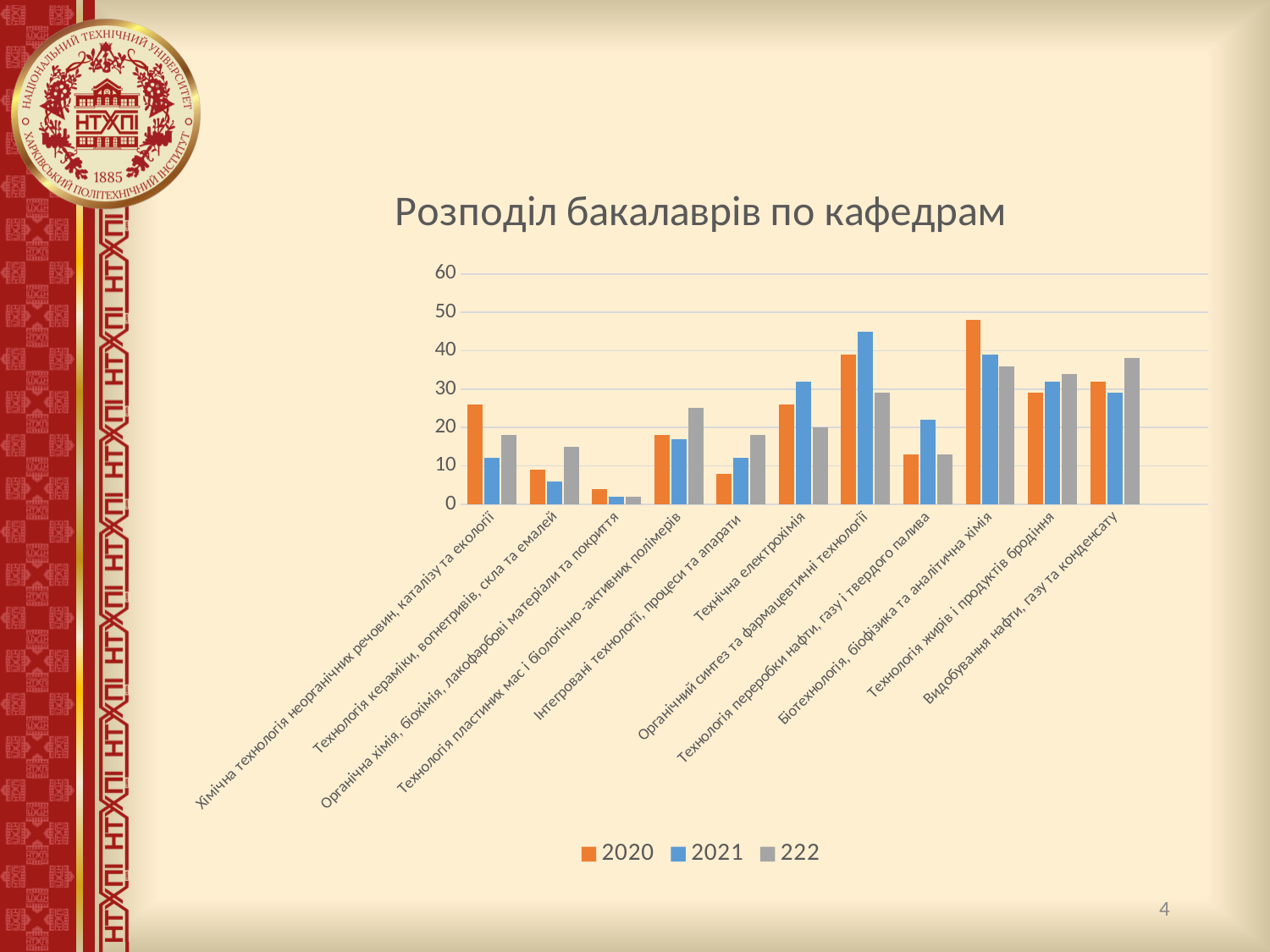
Which category has the highest value for the 2021 series? Органічний синтез та фармацевтичні технології For Хімічна технологія неорганічних речовин, каталізу та екології, which series has the larger value: 2020 or 2021? 2020 How many series does the legend list? 3 How many categories (departments) are shown on the x axis? 11 Is the 2020 value for Біотехнологія, біофізика та аналітична хімія greater or less than 40? greater What kind of chart is shown on the slide? bar chart Is the 2020 value for Органічна хімія, біохімія, лакофарбові матеріали та покриття greater or less than 10? less Is the 222 value for Технологія пластичних мас і біологічно-активних полімерів greater or less than 20? greater What is the title of the chart? Розподіл бакалаврів по кафедрам Which category has the lowest value for the 2020 series? Органічна хімія, біохімія, лакофарбові матеріали та покриття Which category has the highest value for the 2020 series? Біотехнологія, біофізика та аналітична хімія For Органічний синтез та фармацевтичні технології, which series has the larger value: 2020 or 2021? 2021